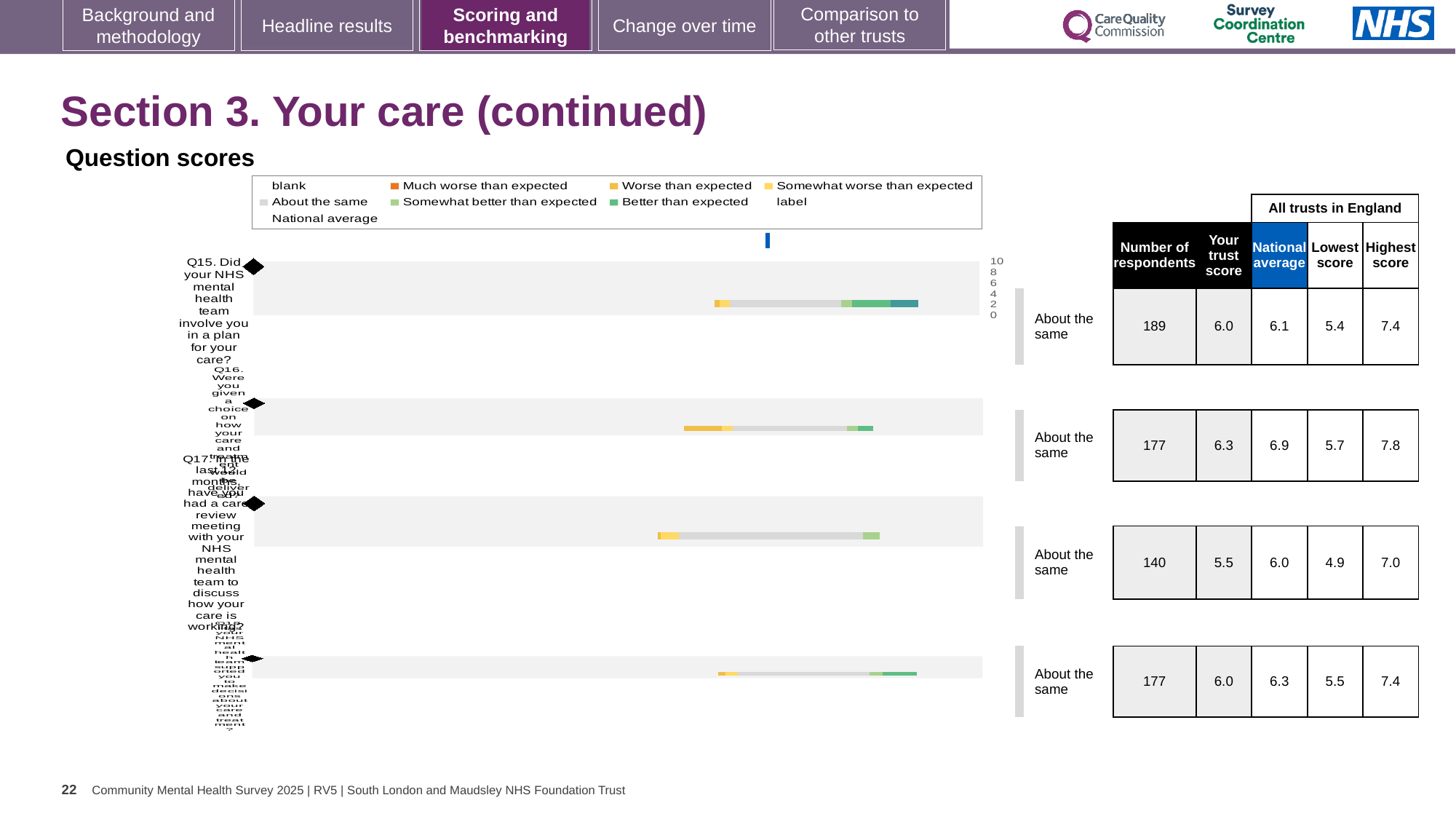
What is the heading above the chart on this slide? Question scores How many questions (rows) are plotted in the question scores chart? 4 What is the 'Lowest score' value for Q16? 5.7 For Q15, which is larger: the trust score or the national average? National average What is the 'Your trust score' value for Q15 (involving you in a plan for your care)? 6.0 How many respondents are listed for Q17 (care review meeting)? 140 What benchmark category is shown for Q17? About the same What kind of chart is used to show the question scores on this slide? bar chart Which question has the lowest 'Lowest score' value in the table? Q17 Which question has the highest 'Highest score' value in the table? Q16 What is the difference between the national average and the trust score for Q16? 0.6 What is the difference between the highest score and the lowest score for Q17? 2.1